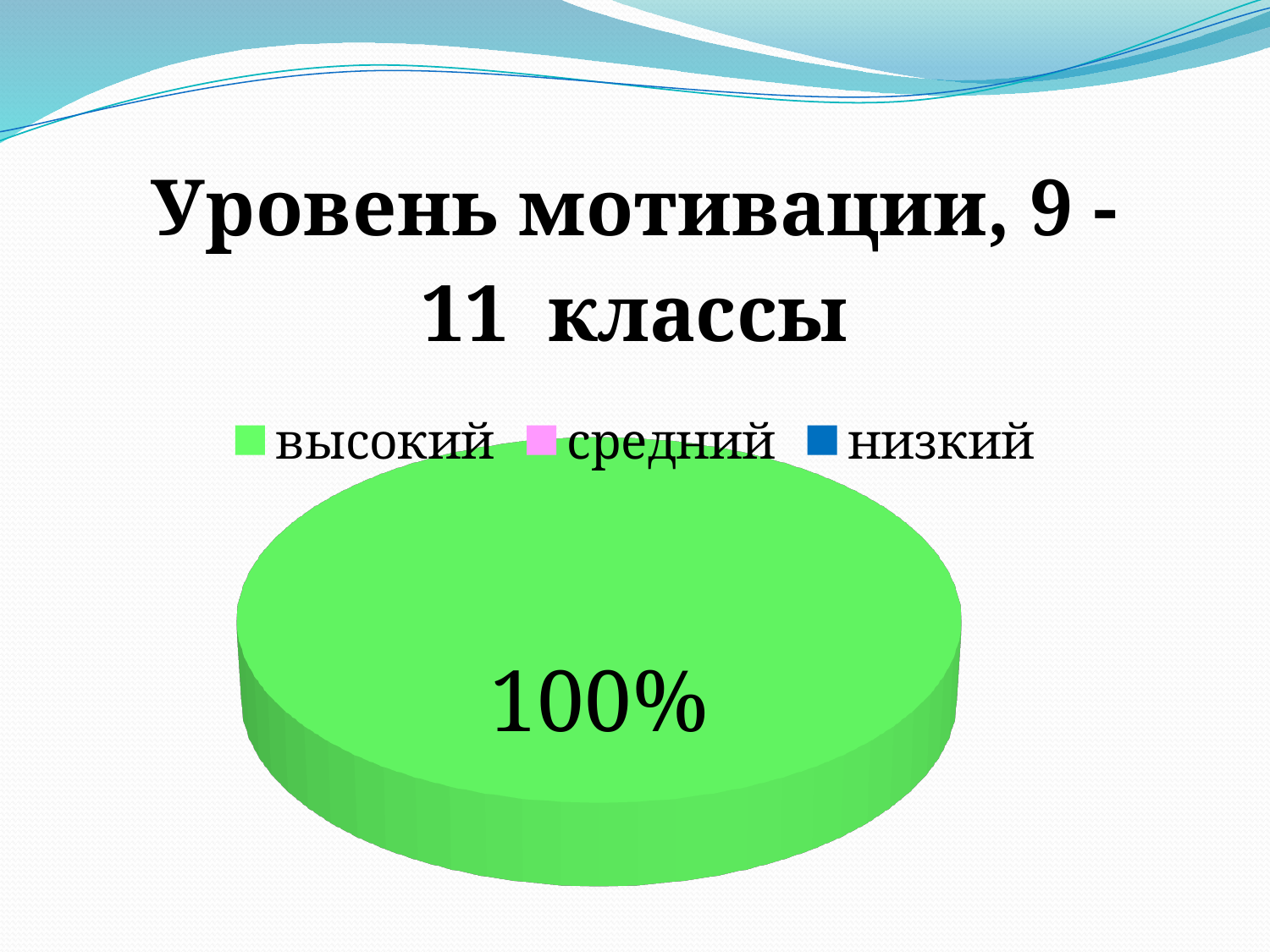
Is the share for 'высокий' greater or less than 50%? greater What kind of chart is shown on the slide? pie chart What share of the pie does the 'высокий' category take? 100% How many slices are visible in the pie? 1 What value is printed on the pie? 100% Which legend entry is shown in green? высокий Which category has the largest share of the pie? высокий How many entries does the legend list? 3 What is the title of the chart? Уровень мотивации, 9 - 11 классы